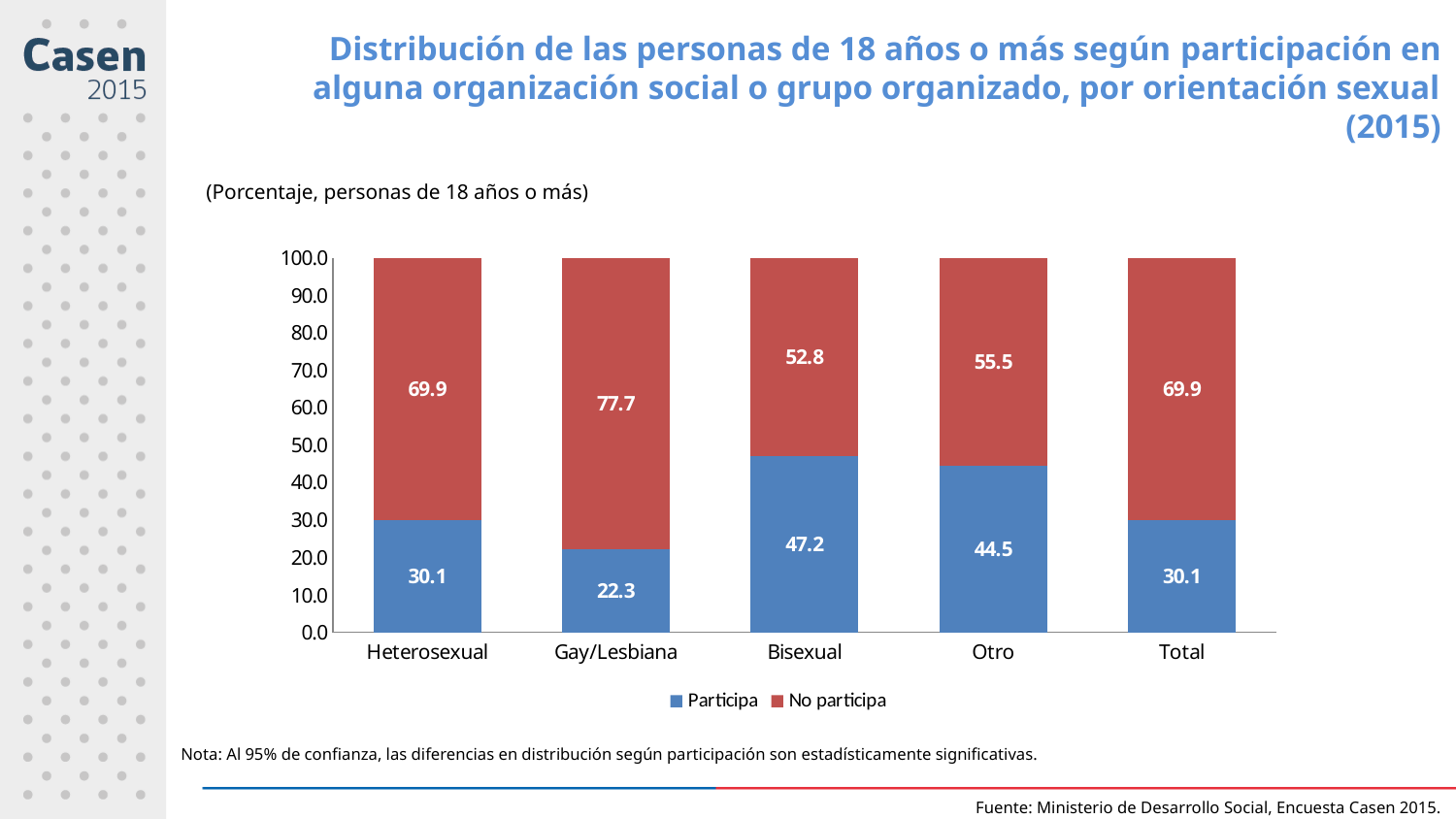
Which category has the lowest "Participa" value? Gay/Lesbiana What kind of chart is shown on the slide? Stacked bar chart What is the value of "Participa" for Otro? 44.5 What is the total of the stacked bar for Total? 100.0 Which category has the highest "Participa" value? Bisexual What is the value of "Participa" for Bisexual? 47.2 What is the value of "No participa" for Gay/Lesbiana? 77.7 Which is larger: the "Participa" value for Heterosexual or for Otro? Otro How many categories are shown on the x axis? 5 How many series does the legend list? 2 Which series is shown in red? No participa What is the difference between the "No participa" values for Gay/Lesbiana and Bisexual? 24.9